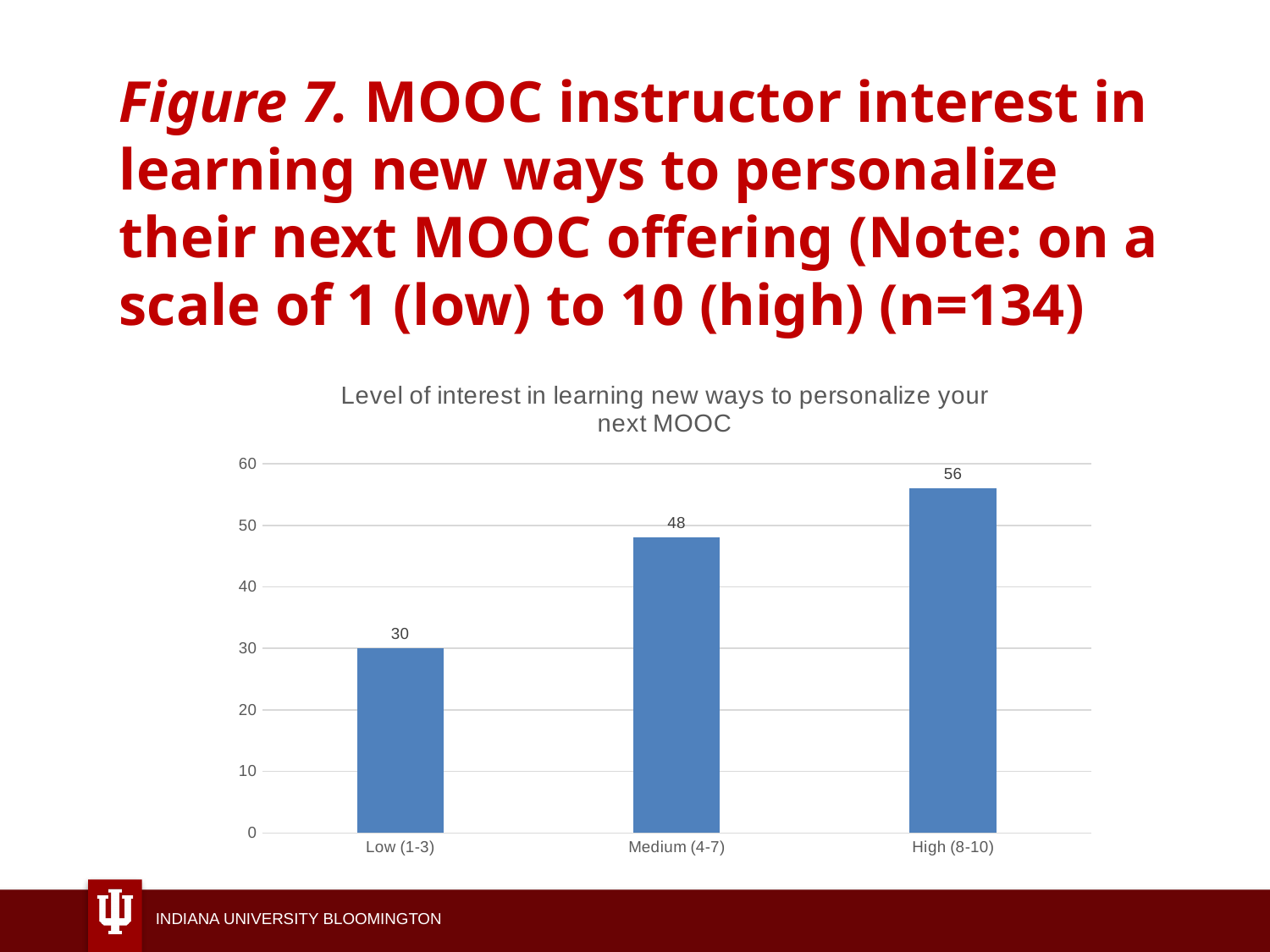
What kind of chart is shown on the slide? bar chart How many categories are shown on the x axis? 3 What is the difference between the values for High (8-10) and Low (1-3)? 26 Is the value for Medium (4-7) greater or less than 40? greater What is the difference between the values for Medium (4-7) and Low (1-3)? 18 What is the value for Medium (4-7)? 48 Which is larger, the value for Medium (4-7) or the value for High (8-10)? High (8-10) What is the value for Low (1-3)? 30 What is the value for High (8-10)? 56 Do the values rise or fall from Low (1-3) to High (8-10)? rise Which category has the lowest value? Low (1-3) Which category has the highest value? High (8-10)